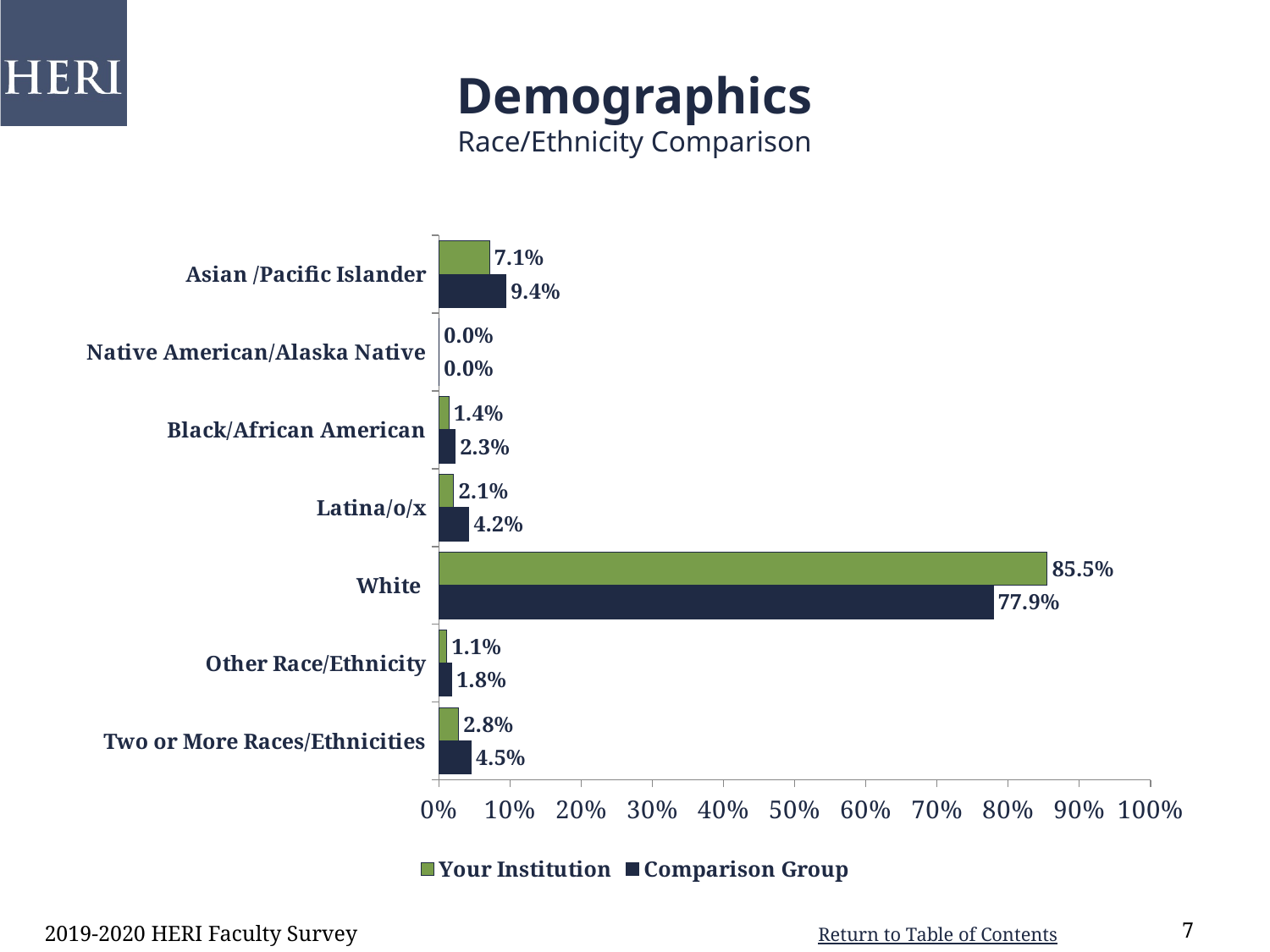
Which is larger for Black/African American: Your Institution or Comparison Group? Comparison Group What kind of chart is shown on the slide? bar chart How many race/ethnicity categories are shown on the chart? 7 Which category has the highest Comparison Group value? White Which category has the lowest Your Institution value? Native American/Alaska Native What is the Your Institution value for White? 85.5% How many series does the legend list? 2 What is the difference between the Your Institution and Comparison Group values for White? 7.6% Is the Comparison Group value for White greater or less than 80%? less What is the difference between the Comparison Group and Your Institution values for Latina/o/x? 2.1% What is the Comparison Group value for Asian /Pacific Islander? 9.4% What is the Your Institution value for Two or More Races/Ethnicities? 2.8%